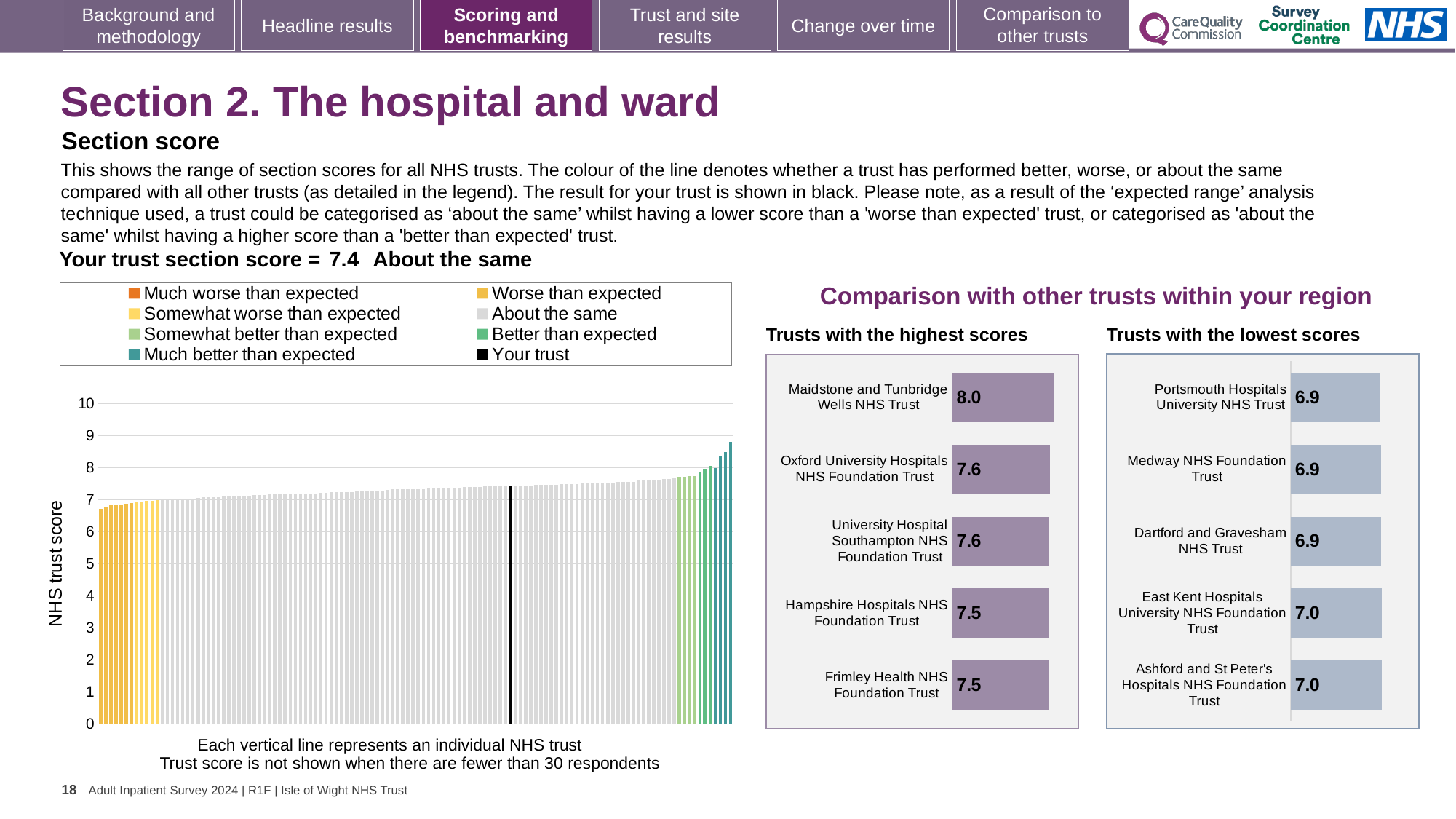
In the left-hand NHS trust score chart, what is the section score for your trust (shown in black)? 7.4 How many trusts are shown in the 'Trusts with the highest scores' chart? 5 What kind of chart is the large chart on the left showing NHS trust scores? Bar chart In the 'Trusts with the lowest scores' chart, which has the larger score: Ashford and St Peter's Hospitals NHS Foundation Trust or Medway NHS Foundation Trust? Ashford and St Peter's Hospitals NHS Foundation Trust In the 'Trusts with the highest scores' chart, which trust has the highest score? Maidstone and Tunbridge Wells NHS Trust In the 'Trusts with the lowest scores' chart, what is the score for Portsmouth Hospitals University NHS Trust? 6.9 In the 'Trusts with the lowest scores' chart, what is the difference between the scores of East Kent Hospitals University NHS Foundation Trust and Dartford and Gravesham NHS Trust? 0.1 In the 'Trusts with the highest scores' chart, what is the score for Frimley Health NHS Foundation Trust? 7.5 How many entries does the legend of the left-hand NHS trust score chart list? 8 In the 'Trusts with the highest scores' chart, what is the difference between the scores of Maidstone and Tunbridge Wells NHS Trust and Hampshire Hospitals NHS Foundation Trust? 0.5 In the 'Trusts with the lowest scores' chart, what is the score for East Kent Hospitals University NHS Foundation Trust? 7.0 In the 'Trusts with the highest scores' chart, what is the score for Maidstone and Tunbridge Wells NHS Trust? 8.0